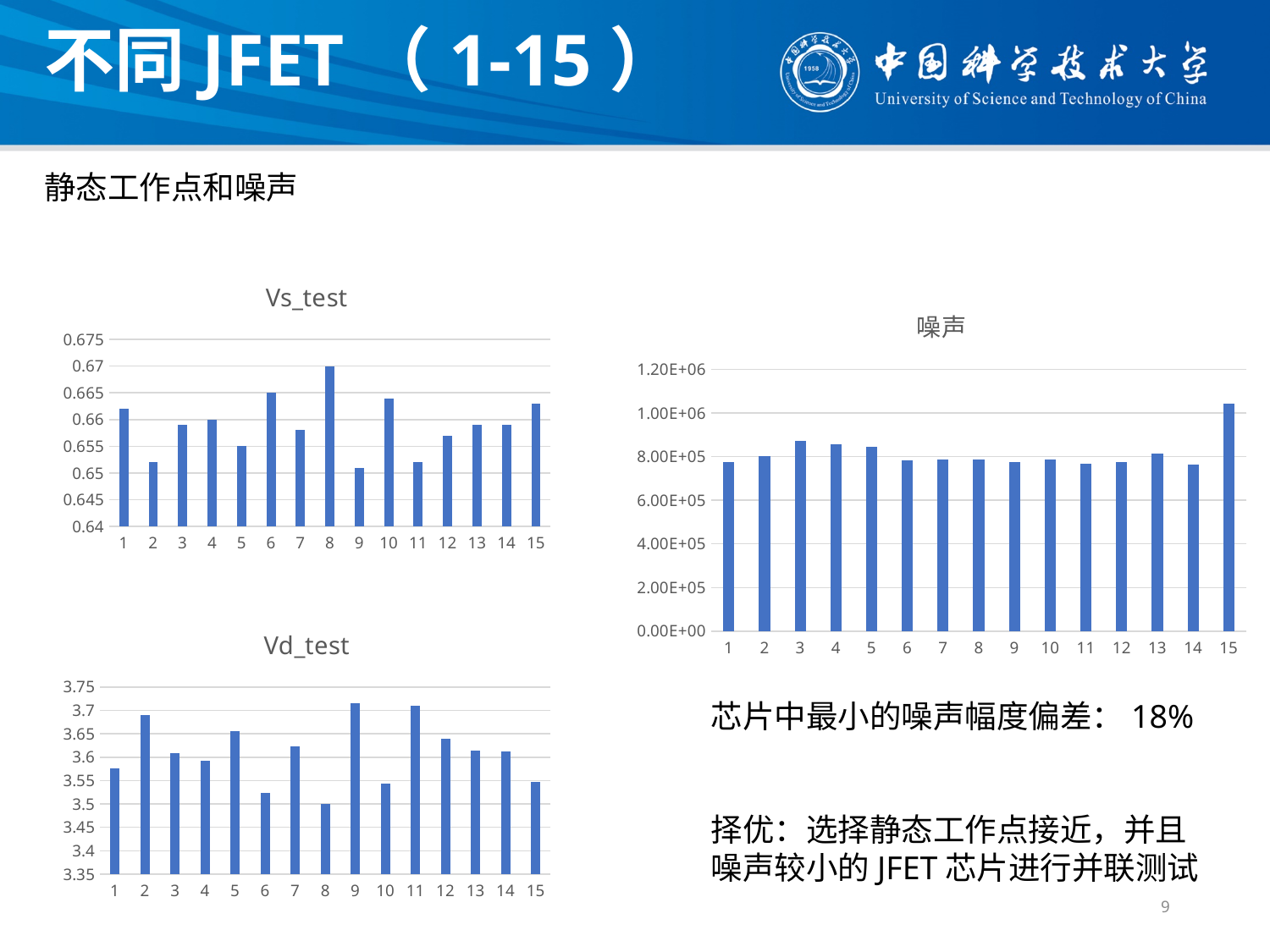
In the Vd_test chart, which is larger, the value for category 2 or the value for category 8? 2 In the Vs_test chart, is the value for category 9 greater or less than 0.655? less In the Vd_test chart, is the value for category 6 greater or less than 3.55? less In the 噪声 chart, is the value for category 15 greater or less than 1.00E+06? greater In the 噪声 chart, which category has the highest value? 15 How many categories are shown on the x axis of the 噪声 chart? 15 What type of chart is the Vs_test chart? bar chart In the Vd_test chart, is the value for category 2 greater or less than 3.65? greater In the Vs_test chart, what is the value for category 6? 0.665 In the Vs_test chart, what is the value for category 8? 0.67 In the Vs_test chart, which category has the highest value? 8